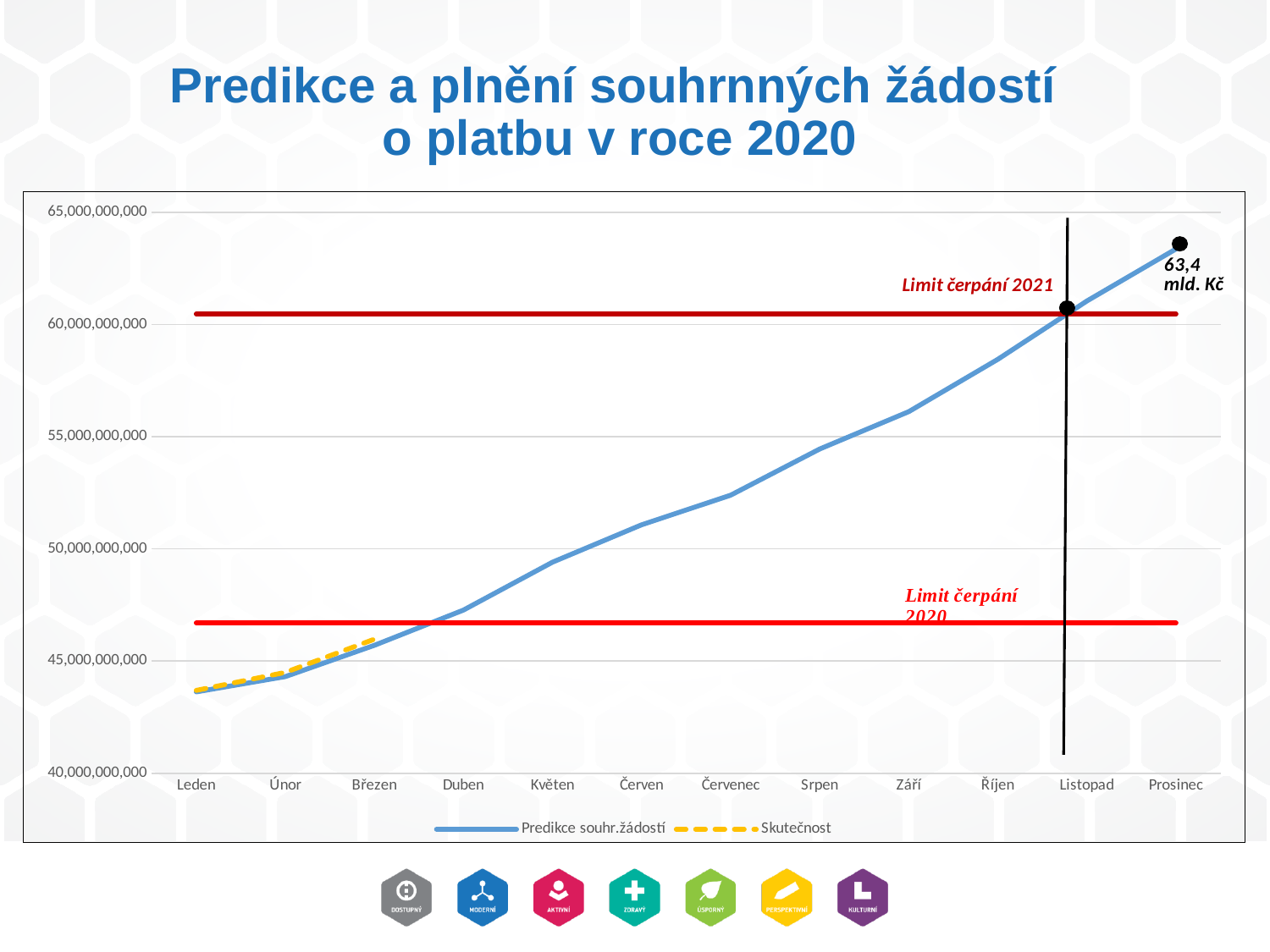
In which month is the Predikce souhr.žádostí value lowest? Leden In which month is the Predikce souhr.žádostí value highest? Prosinec Is the Predikce souhr.žádostí value for Leden greater or less than 45,000,000,000? less Is the Predikce souhr.žádostí value for Září greater or less than 55,000,000,000? greater What are the two series named in the legend? Predikce souhr.žádostí and Skutečnost Which is larger, the Predikce souhr.žádostí value for Prosinec or for Leden? Prosinec How many months are shown on the x axis? 12 How many series does the legend list? 2 Does the Predikce souhr.žádostí line rise or fall from Leden to Prosinec? rise What kind of chart is shown on the slide? line chart What value is labelled at the Prosinec point of the prediction line? 63,4 mld. Kč Is the Predikce souhr.žádostí value for Prosinec greater or less than 60,000,000,000? greater